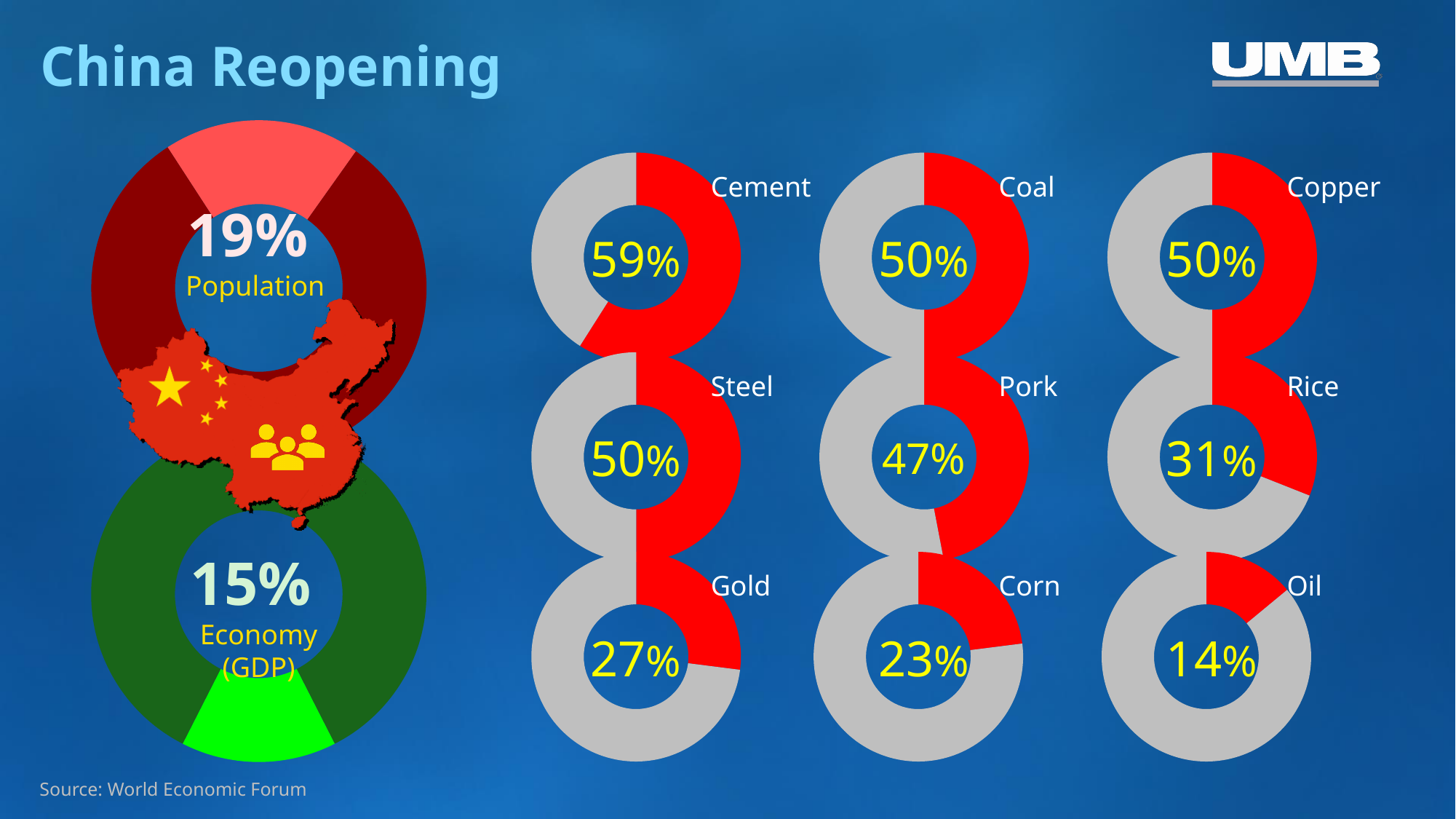
What is the difference between the Population percentage and the Economy (GDP) percentage in the two donut charts on the left? 4% What is the difference between the percentage in the Cement donut chart and the percentage in the Oil donut chart? 45% In the Population donut chart on the left, what percentage is shown? 19% In the Oil donut chart, what percentage is shown? 14% In the Corn donut chart, what percentage is shown? 23% How many commodity donut charts are shown on the right side of the slide? 9 Among the nine commodity donut charts (Cement, Coal, Copper, Steel, Pork, Rice, Gold, Corn, Oil), which commodity has the highest percentage? Cement Comparing the Rice donut chart and the Gold donut chart, which shows the larger percentage? Rice In the Cement donut chart, what percentage is shown? 59% In the Economy (GDP) donut chart on the left, what percentage is shown? 15% What kind of chart is used to show the Pork value? Donut chart Among the nine commodity donut charts (Cement, Coal, Copper, Steel, Pork, Rice, Gold, Corn, Oil), which commodity has the lowest percentage? Oil